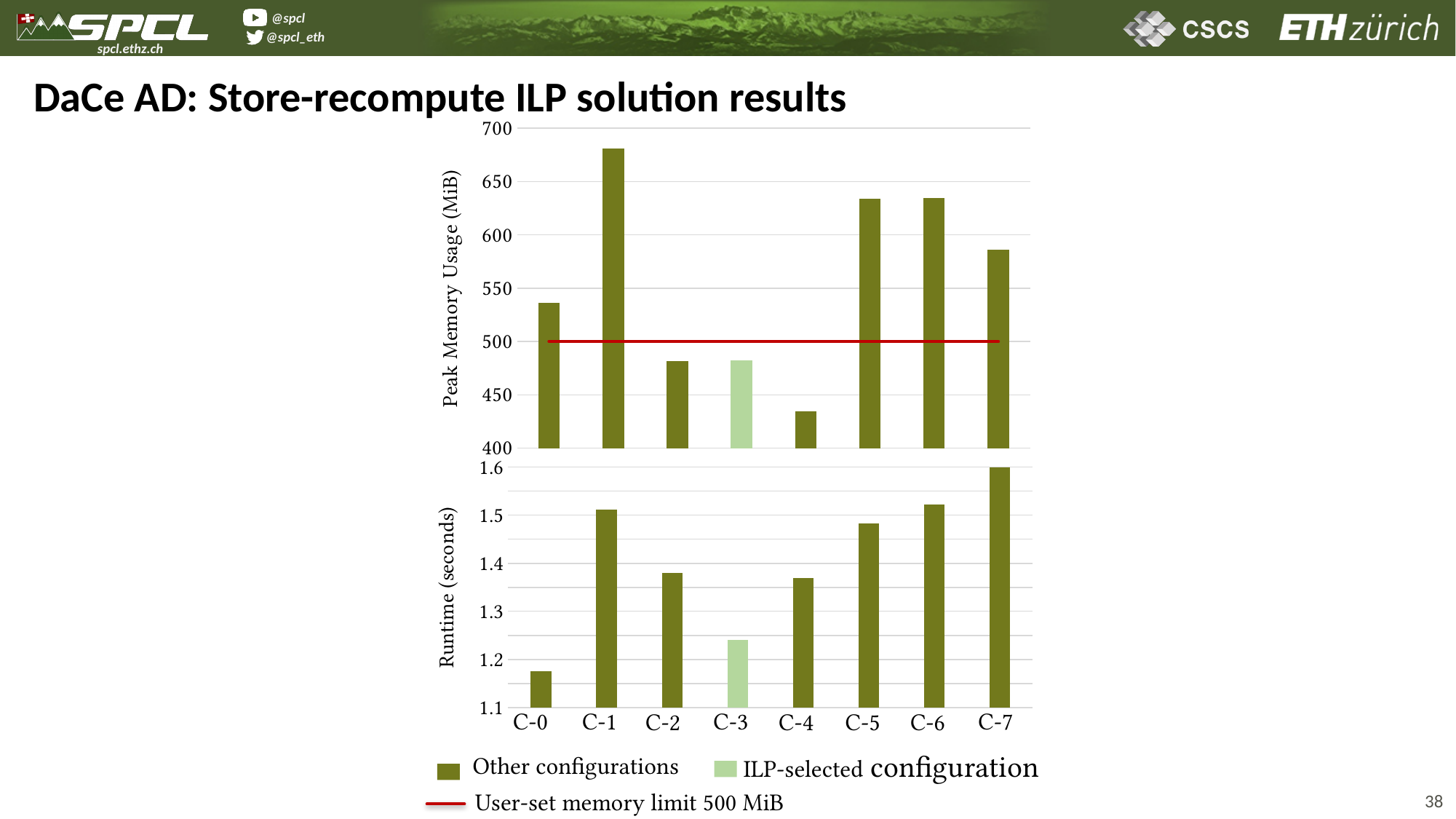
What kind of chart is the Peak Memory Usage chart at the top of the slide? bar chart In the Runtime chart at the bottom, which configuration has the highest runtime? C-7 In the Peak Memory Usage chart at the top, is the value for C-4 greater or less than 450? less What user-set memory limit does the red line in the Peak Memory Usage chart represent, according to the legend? 500 MiB In the Peak Memory Usage chart at the top, which configuration has the highest peak memory usage? C-1 In the Runtime chart at the bottom, which configuration has the lowest runtime? C-0 How many configurations are plotted along the x axis of the Runtime chart at the bottom of the slide? 8 In the Runtime chart at the bottom, which has the larger runtime, C-6 or C-2? C-6 In the Runtime chart at the bottom, is the value for C-3 greater or less than 1.3? less Which configuration is shown as the ILP-selected configuration in the charts? C-3 In the Peak Memory Usage chart at the top, which configuration has the lowest peak memory usage? C-4 In the Peak Memory Usage chart at the top, is the value for C-0 greater or less than 500? greater